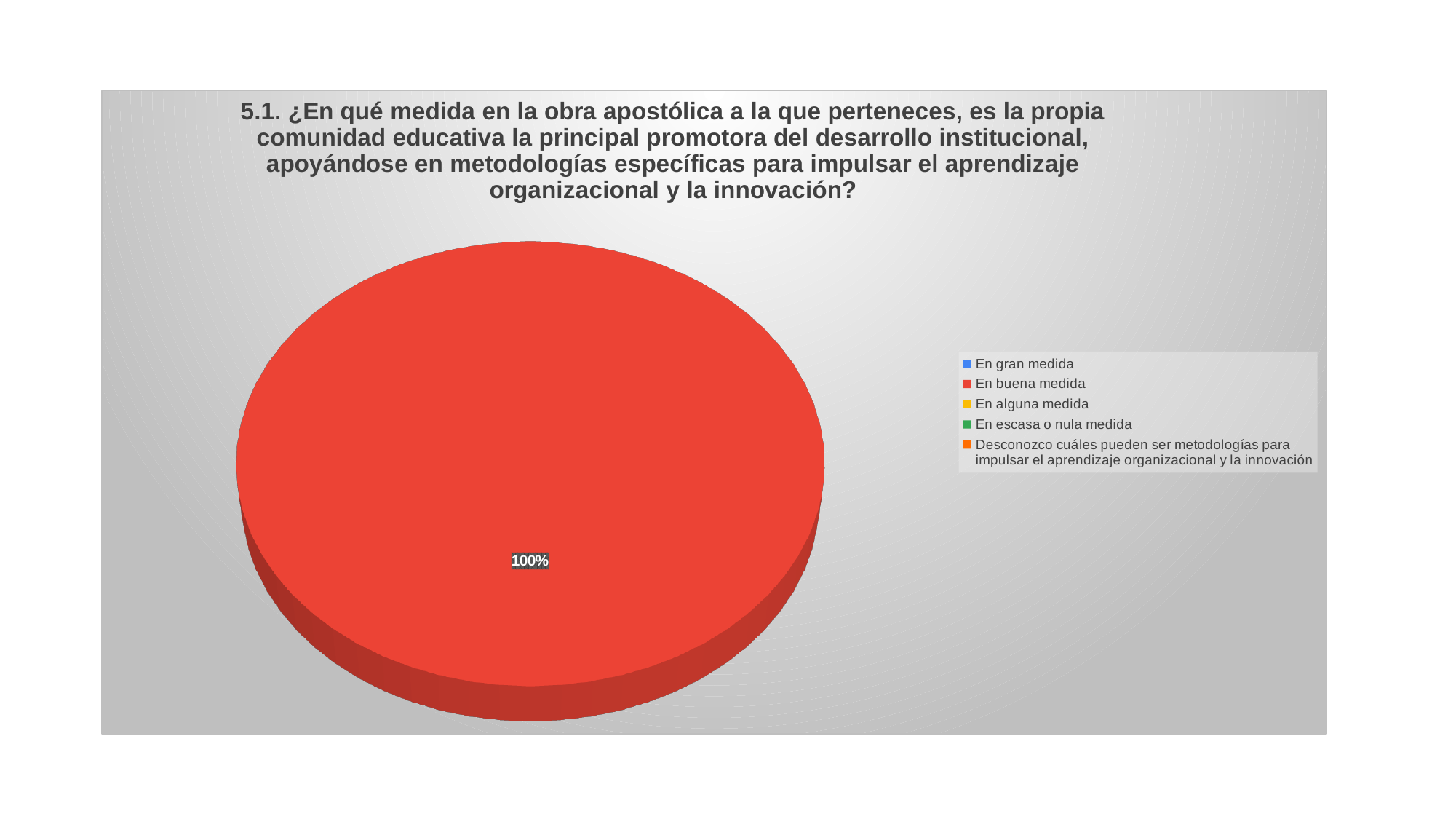
How many slices are visible in the pie? 1 Is the share for "En buena medida" greater or less than 50%? greater What kind of chart is shown on the slide? Pie chart What share of the pie does "En buena medida" hold? 100% What colour is the slice labelled 100%? Red Which category accounts for the largest share of the pie? En buena medida Which legend entry is shown in blue? En gran medida How many entries does the legend list? 5